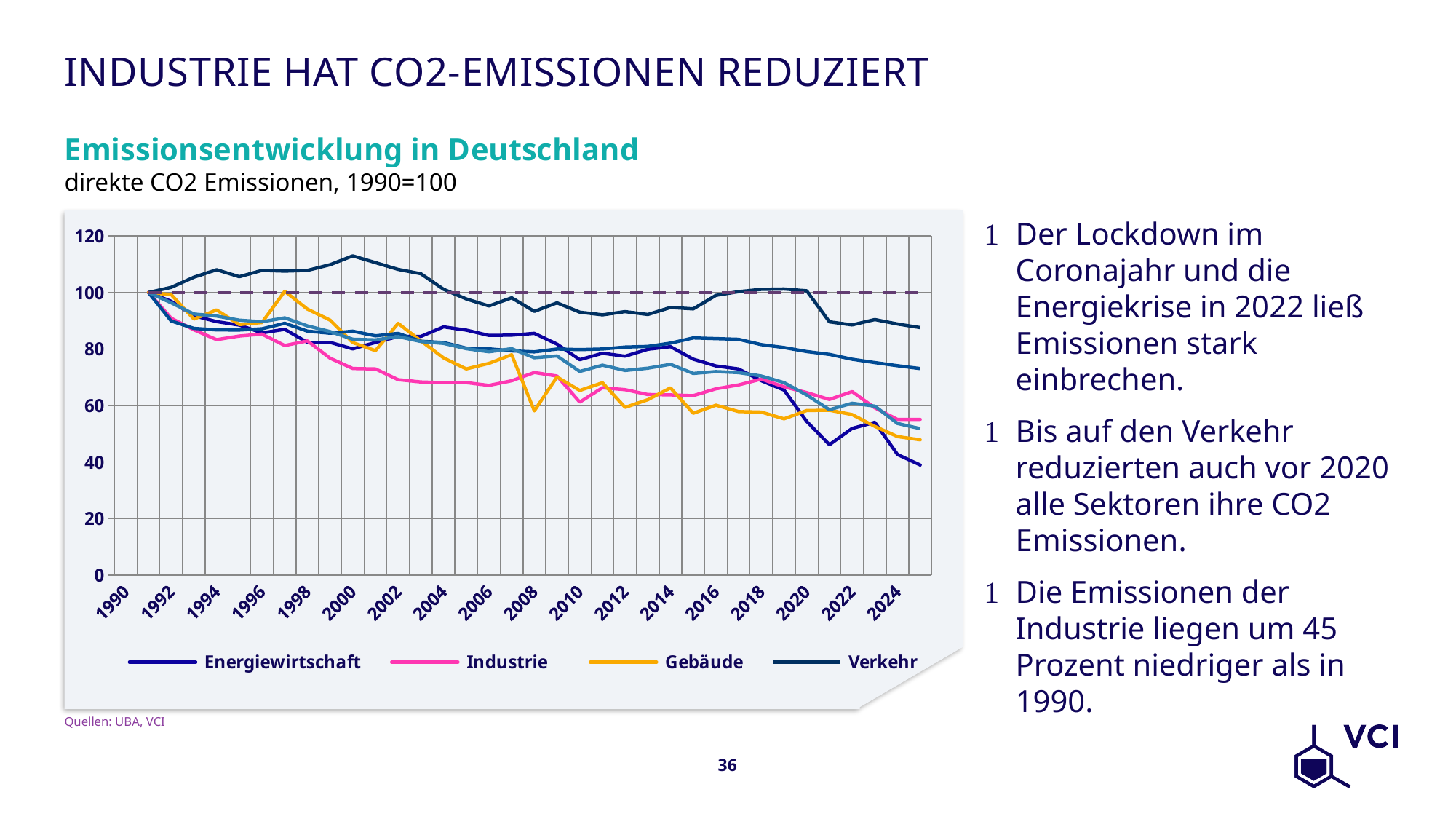
How many series does the chart legend list? 4 Is the value for Gebäude in 2024 greater or less than 60? less What is the title of the chart? Emissionsentwicklung in Deutschland What kind of chart is shown on the slide? line chart Which series has the highest value in 2024? Verkehr Which series has the lowest value in 2024? Energiewirtschaft Is the value for Energiewirtschaft in 2024 greater or less than 60? less Does the Industrie series rise or fall overall from 1990 to 2024? fall Is the value for Verkehr in 2000 greater or less than 100? greater In 2024, which is larger: the value for Verkehr or the value for Industrie? Verkehr What is the value of the Industrie series in 1990? 100